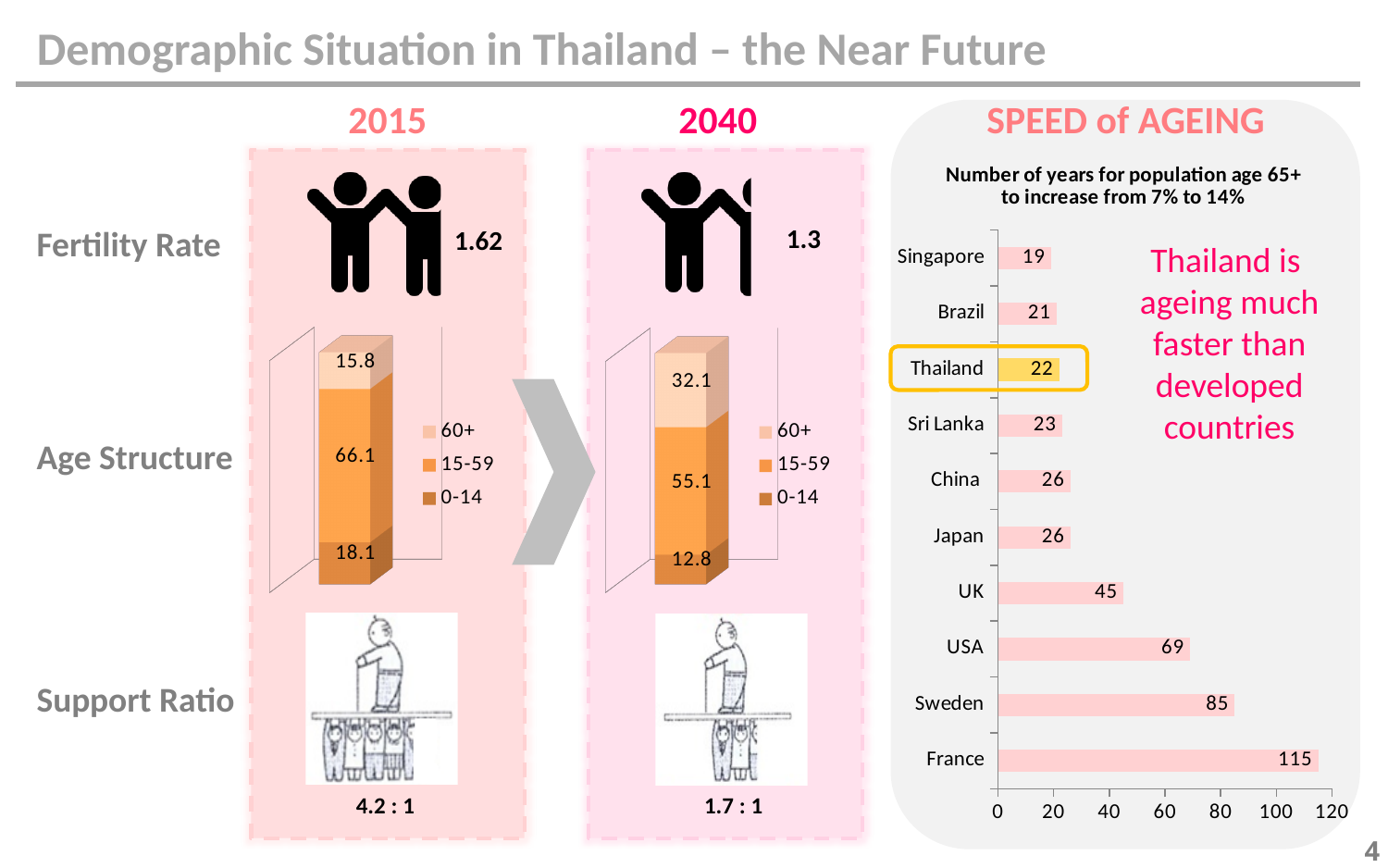
In the 2040 Age Structure chart, what is the value for the 60+ group? 32.1 What kind of chart is the Speed of Ageing chart? Bar chart In the Speed of Ageing chart, what is the value for Sweden? 85 How many series does the legend of the 2015 Age Structure chart list? 3 In the Speed of Ageing chart, which has a larger value, the UK or the USA? USA In the 2040 Age Structure chart, what is the total of the stacked bar? 100 In the Speed of Ageing chart, what is the difference in years between France and Thailand? 93 In the Speed of Ageing chart, how many years does it take for Thailand's population aged 65+ to increase from 7% to 14%? 22 In the 2015 Age Structure chart, what is the value for the 15-59 group? 66.1 In the Speed of Ageing chart, which country has the highest number of years? France In the Speed of Ageing chart, which country has the lowest number of years? Singapore How many countries are shown in the Speed of Ageing chart? 10